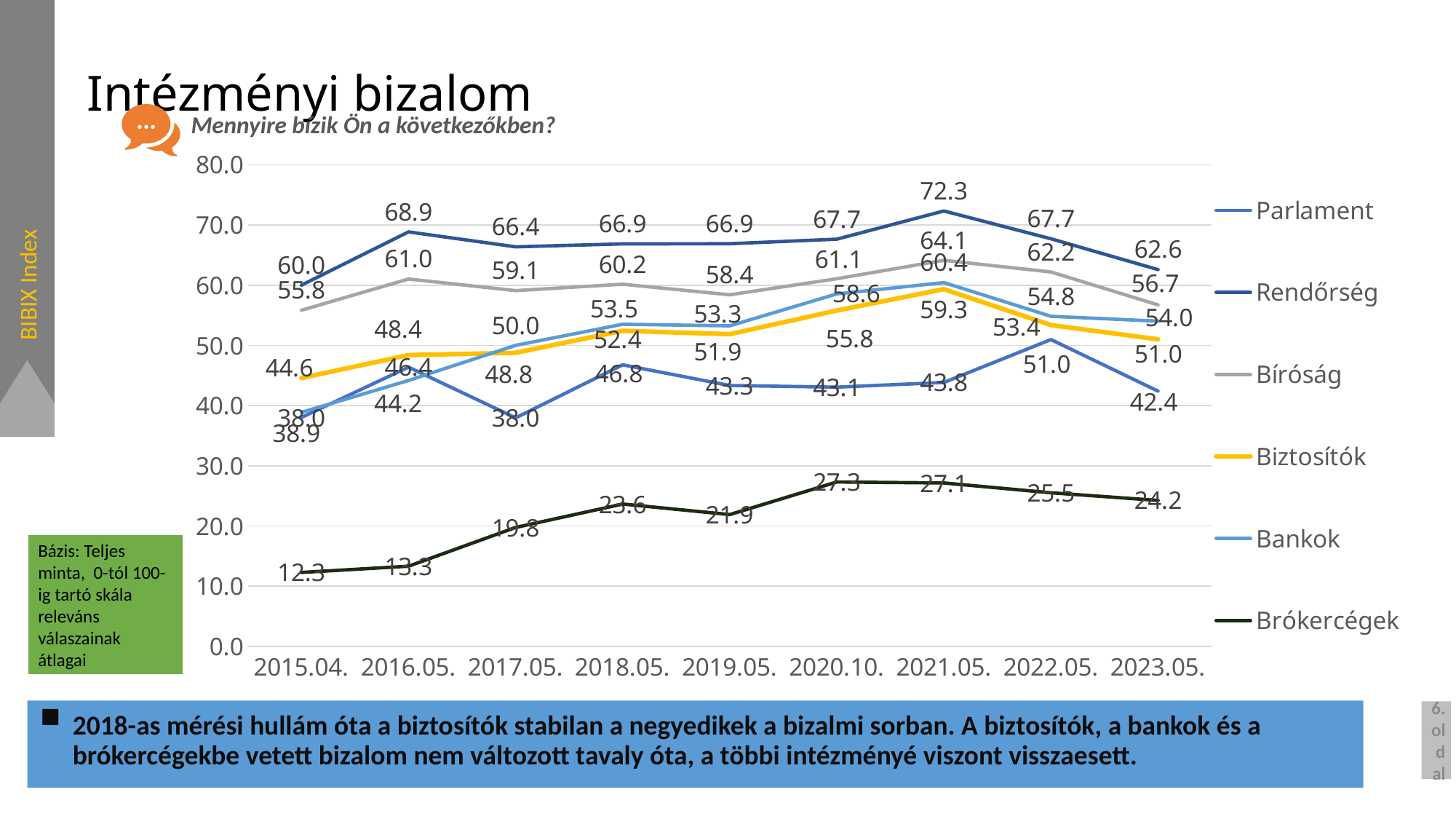
What is the value for Brókercégek at 2015.04.? 12.3 At which time point is the Brókercégek value lowest? 2015.04. How many time points are shown on the x axis? 9 What kind of chart is shown on the slide? line chart At which time point does Rendőrség reach its highest value? 2021.05. Does the Brókercégek line overall rise or fall from 2015.04. to 2023.05.? rise What is the title of the slide containing the chart? Intézményi bizalom At 2023.05., which is higher: Bankok or Biztosítók? Bankok What is the difference between the Rendőrség value at 2021.05. and at 2023.05.? 9.7 What is the value for Bíróság at 2023.05.? 56.7 How many series does the legend list? 6 What is the value for Rendőrség at 2021.05.? 72.3